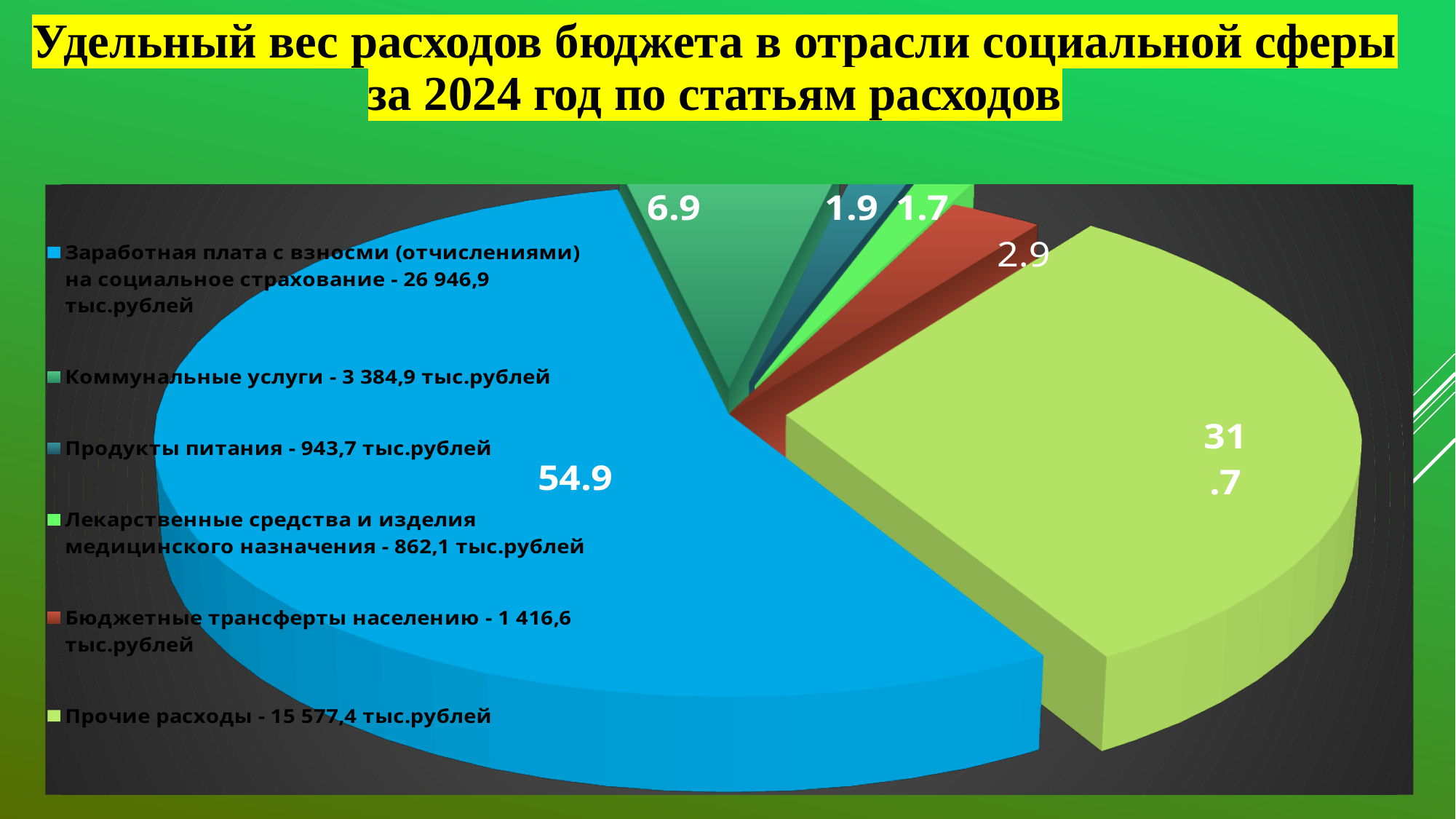
What share of the pie is labelled for Лекарственные средства и изделия медицинского назначения? 1.7 What share of the pie is labelled for Бюджетные трансферты населению? 2.9 Which category has the largest slice of the pie? Заработная плата с взносми (отчислениями) на социальное страхование What kind of chart is shown on the slide? pie chart Which slice is larger: Коммунальные услуги or Бюджетные трансферты населению? Коммунальные услуги What share of the pie is labelled for Заработная плата с взносми (отчислениями) на социальное страхование? 54.9 How many slices does the pie chart have? 6 What share of the pie is labelled for Прочие расходы? 31.7 What is the difference between the labelled shares for Заработная плата and Прочие расходы? 23.2 Which category has the smallest slice of the pie? Лекарственные средства и изделия медицинского назначения What share of the pie is labelled for Коммунальные услуги? 6.9 According to the legend, what amount in тыс.рублей is given for Продукты питания? 943,7 тыс.рублей